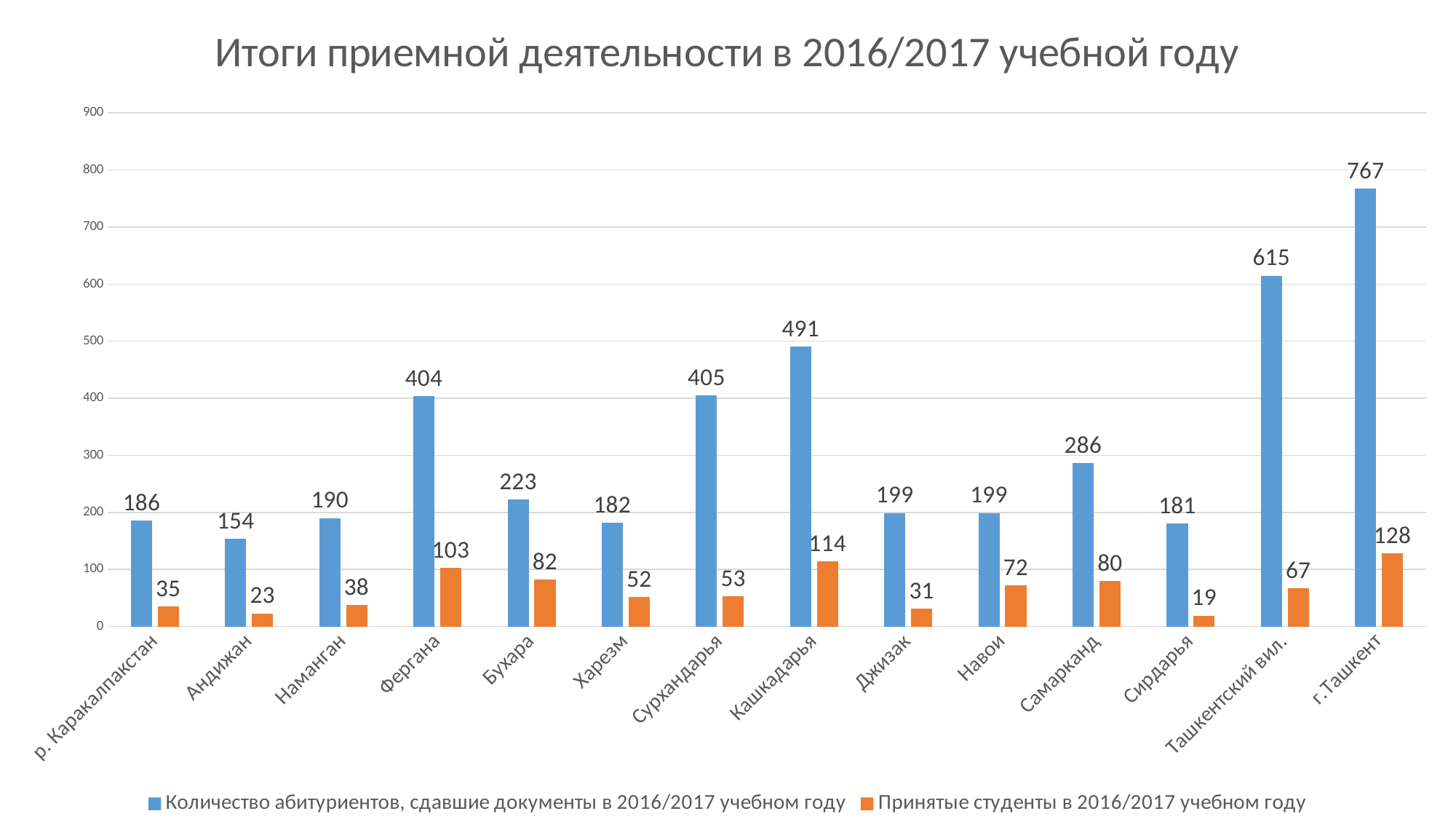
Which region has the lowest number of applicants who submitted documents? Андижан What is the difference in the number of applicants between Ташкентский вил. and Кашкадарья? 124 What is the title of the chart? Итоги приемной деятельности в 2016/2017 учебной году Which region has the highest number of applicants who submitted documents? г. Ташкент What is the difference between applicants and admitted students for г. Ташкент? 639 How many series does the legend list? 2 What type of chart is shown on the slide? bar chart How many regions (categories) are shown on the x axis? 14 What is the number of applicants who submitted documents (Количество абитуриентов) for Кашкадарья? 491 Which region has more admitted students, Бухара or Самарканд? Бухара Which region has the lowest number of admitted students? Сирдарья How many admitted students (Принятые студенты) are shown for Фергана? 103